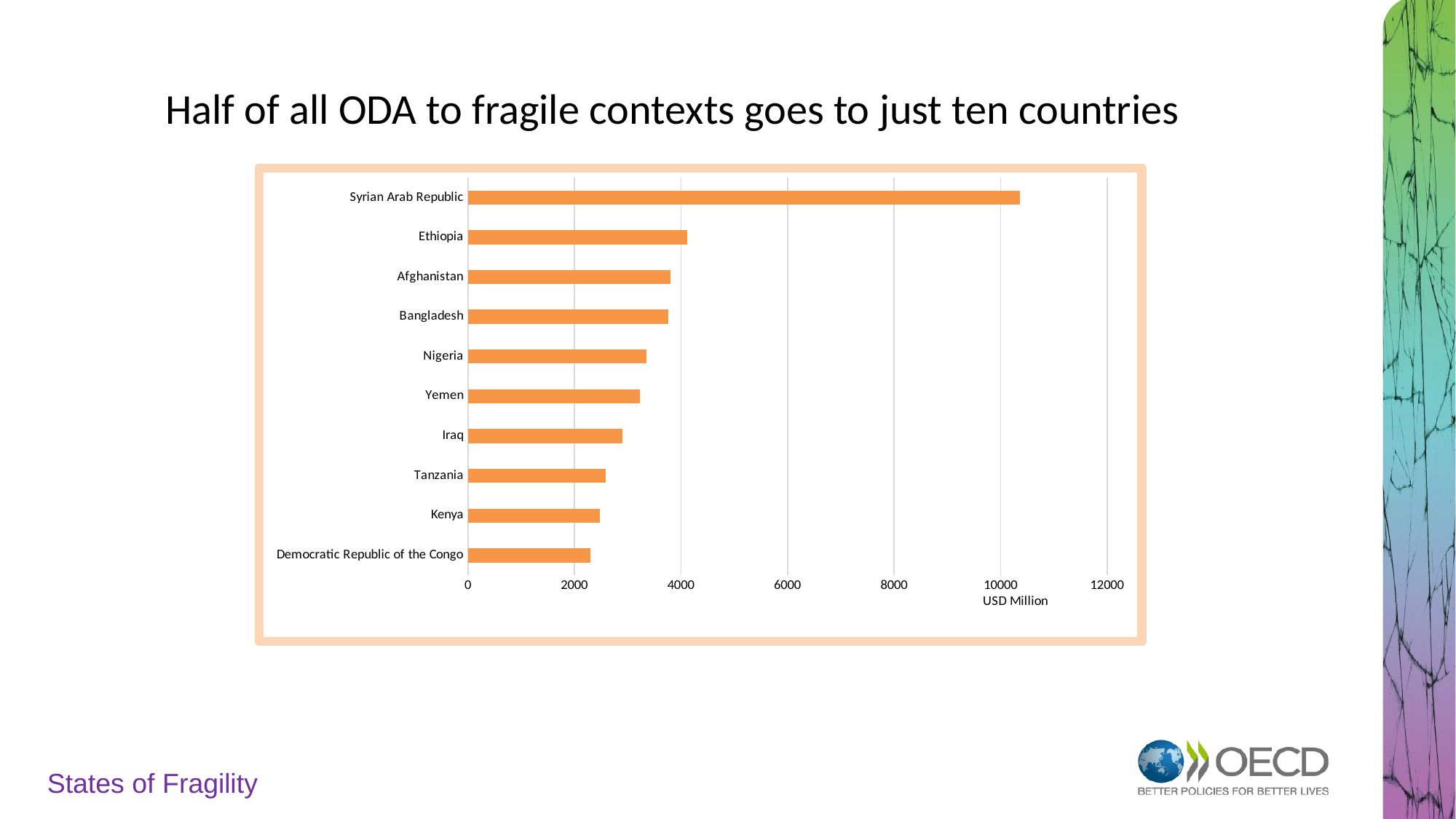
What unit is shown on the horizontal axis of the chart? USD Million How many countries are shown in the chart? 10 Which has a larger value, Nigeria or Kenya? Nigeria Is the value for Ethiopia greater or less than 6000? less Which country has the lowest ODA value in the chart? Democratic Republic of the Congo Is the value for Syrian Arab Republic greater or less than 8000? greater Is the value for Kenya greater or less than 4000? less Which country has the highest ODA value in the chart? Syrian Arab Republic What kind of chart is shown on the slide? bar chart Which has a larger value, Syrian Arab Republic or Ethiopia? Syrian Arab Republic